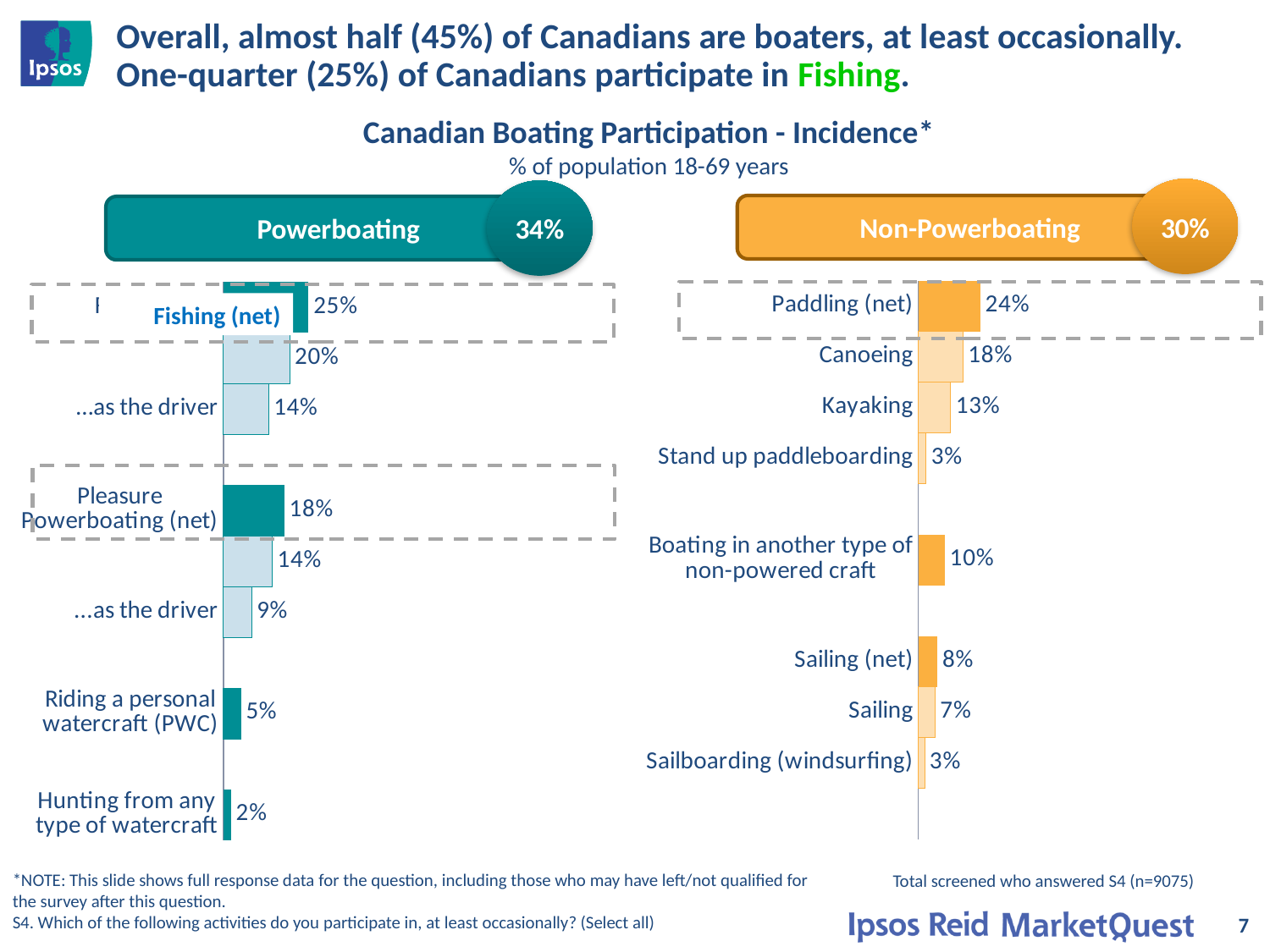
In the Powerboating chart, what is the value for Riding a personal watercraft (PWC)? 5% In the Powerboating chart, which category has the lowest value? Hunting from any type of watercraft What is the overall incidence shown for Non-Powerboating? 30% In the Non-Powerboating chart, which category has the highest value? Paddling (net) In the Non-Powerboating chart, which is larger: Boating in another type of non-powered craft or Sailing (net)? Boating in another type of non-powered craft In the Non-Powerboating chart, what is the value for Kayaking? 13% In the Powerboating chart, what is the difference between Fishing (net) and Pleasure Powerboating (net)? 7% In the Non-Powerboating chart, what is the difference between Canoeing and Kayaking? 5% In the Powerboating chart, what is the value for Hunting from any type of watercraft? 2% What type of chart is used on this slide? Bar chart In the Powerboating chart, what is the value for Fishing (net)? 25% In the Non-Powerboating chart, what is the value for Canoeing? 18%